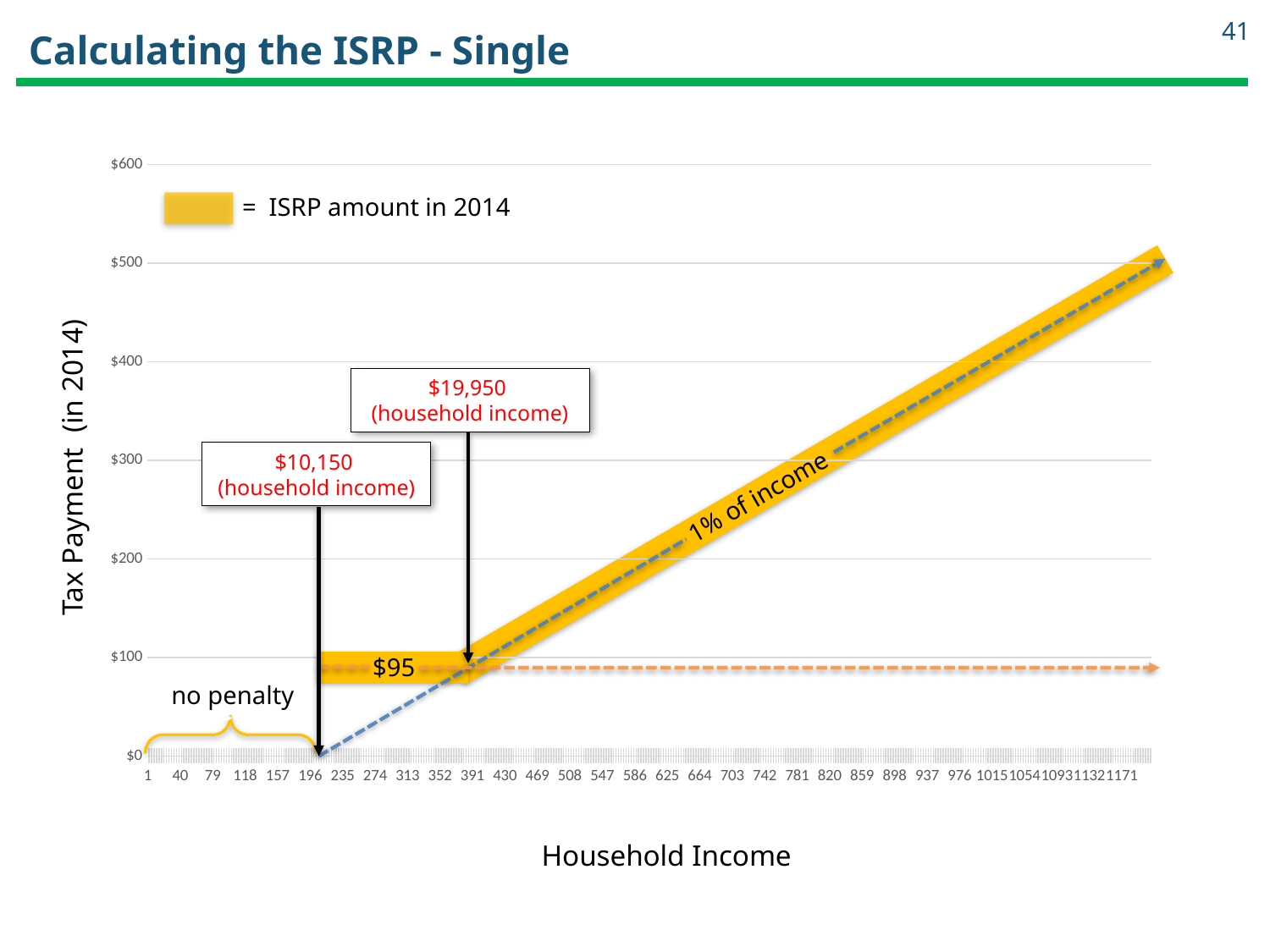
What is the flat ISRP amount labelled on the chart between the $10,150 and $19,950 household income markers? $95 What does the yellow band in the legend represent? ISRP amount in 2014 What is the title of the y axis? Tax Payment (in 2014) Is the ISRP amount at the right-hand end of the chart greater or less than $400? greater Is the ISRP amount at the right-hand end of the chart greater or less than $600? less What is the highest value shown on the y axis? $600 Does the ISRP amount rise or fall as household income increases beyond $19,950? rise What label describes the household income range below $10,150 on the chart? no penalty At what household income does the chart mark the point where the ISRP switches from the flat amount to 1% of income? $19,950 What label is written along the sloped part of the ISRP line? 1% of income At what household income does the chart mark the start of the penalty (end of the 'no penalty' range)? $10,150 What kind of chart is shown on the slide? line chart